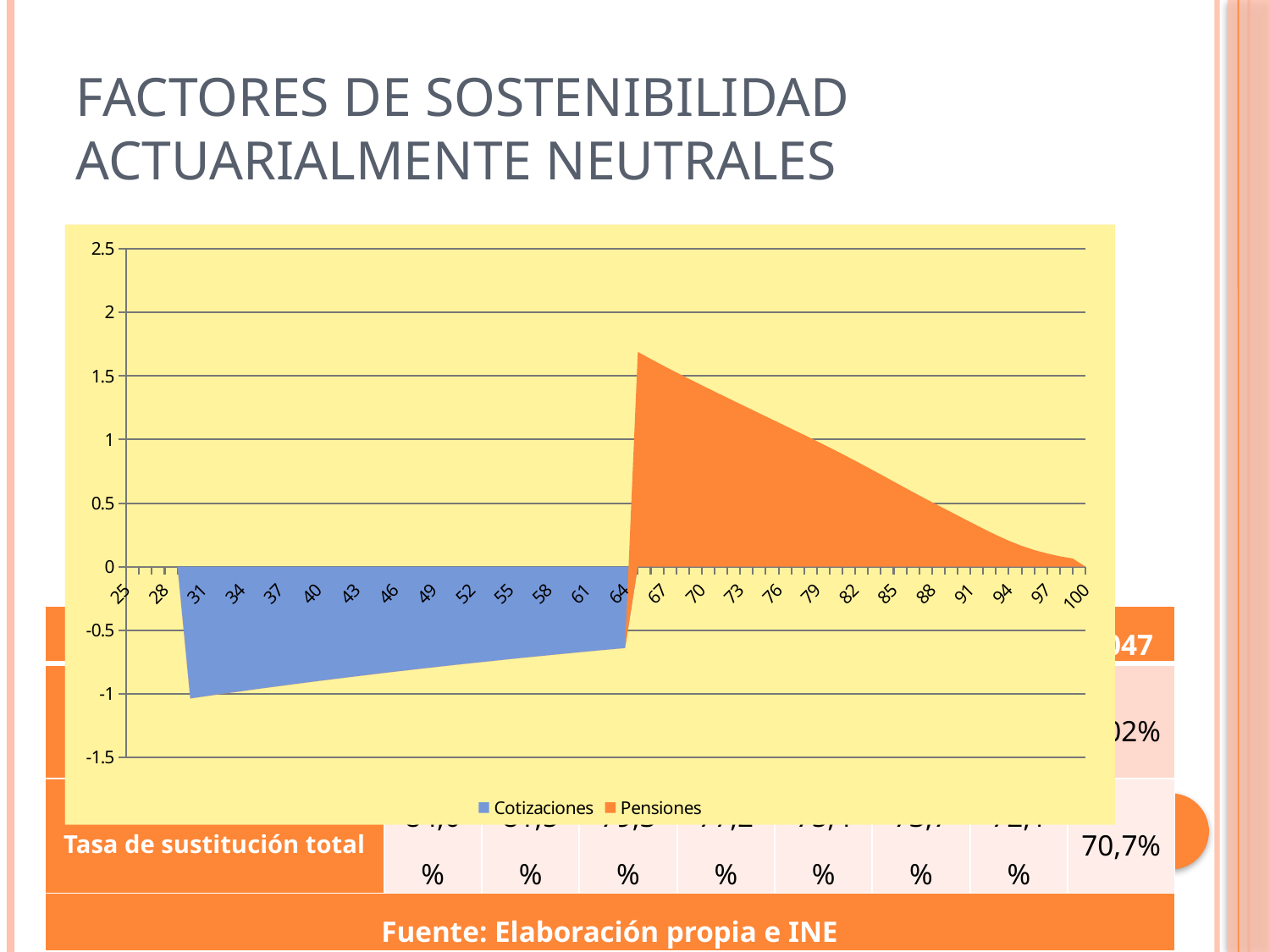
Is the value of Pensiones at 94 greater or less than 0.5? less Which series has negative values in the chart? Cotizaciones Which series is drawn in orange in the chart? Pensiones Is the value of Cotizaciones at 46 greater or less than -0.5? less What is the highest value shown on the chart's vertical axis? 2.5 How many labels are shown on the chart's horizontal axis? 26 Do the Pensiones values rise or fall as the x axis goes from 67 to 100? fall How many series does the chart legend list? 2 Is the value of Pensiones at 70 greater or less than 1? greater What kind of chart is shown on the slide? Area chart What are the two series named in the chart legend? Cotizaciones and Pensiones